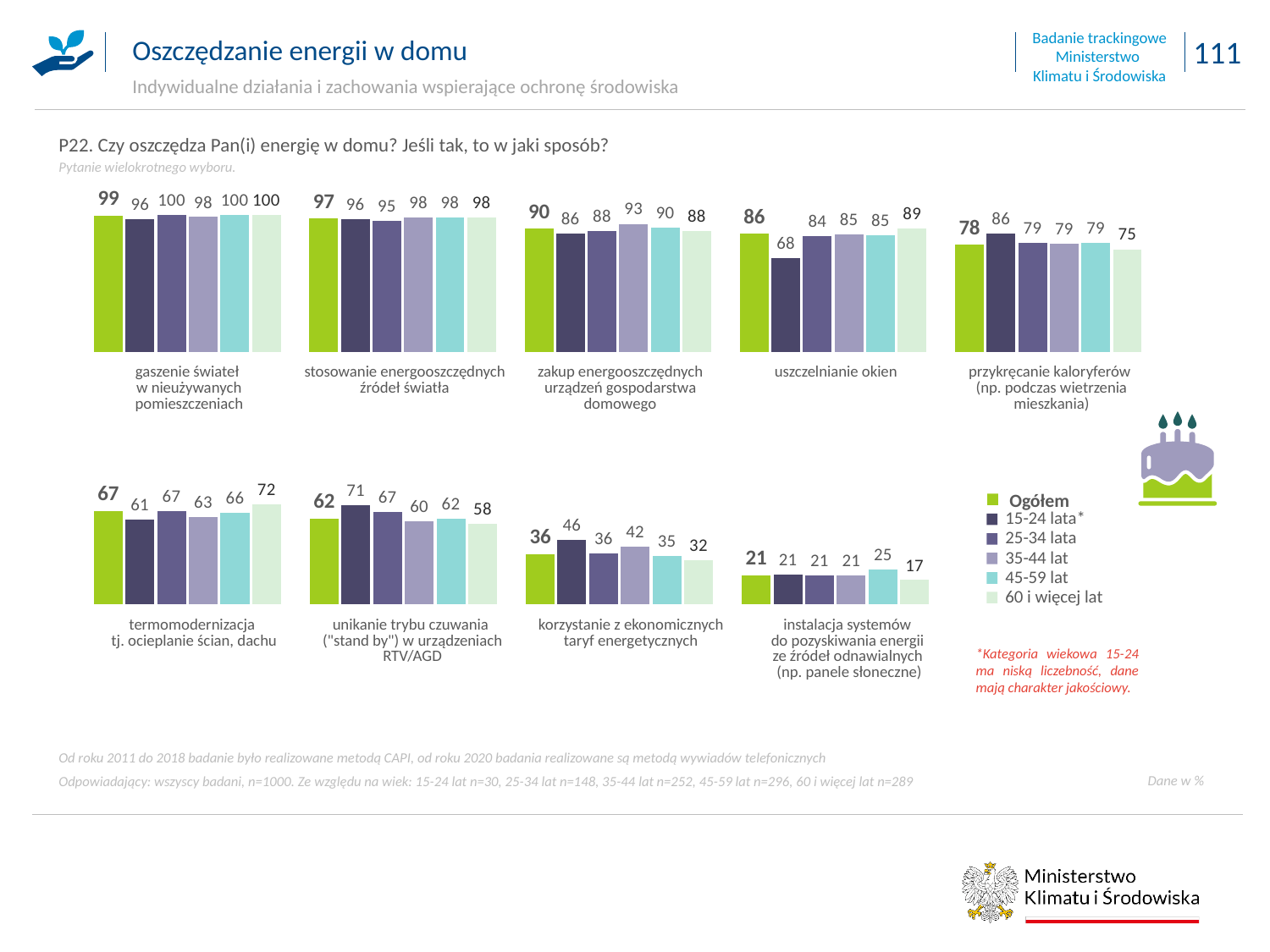
What kind of chart is used for 'zakup energooszczędnych urządzeń gospodarstwa domowego'? bar chart Which legend entry is shown in green? Ogółem In the chart for 'uszczelnianie okien', what is the difference between the 60 i więcej lat value and the 15-24 lata value? 21 In the chart for 'termomodernizacja tj. ocieplanie ścian, dachu', which is larger: the value for 60 i więcej lat or the value for 15-24 lata? 60 i więcej lat In the chart for 'unikanie trybu czuwania ("stand by") w urządzeniach RTV/AGD', which age group has the lowest value? 60 i więcej lat In the chart for 'uszczelnianie okien', what is the value for the 15-24 lata age group? 68 How many series does the legend list? 6 In the chart for 'instalacja systemów do pozyskiwania energii ze źródeł odnawialnych', what is the value for the 45-59 lat group? 25 In the chart for 'zakup energooszczędnych urządzeń gospodarstwa domowego', what is the value for the 35-44 lat group? 93 In the chart for 'korzystanie z ekonomicznych taryf energetycznych', which age group has the highest value? 15-24 lata How many bars are shown in the chart for 'gaszenie świateł w nieużywanych pomieszczeniach'? 6 In the chart for 'przykręcanie kaloryferów', what is the Ogółem value? 78